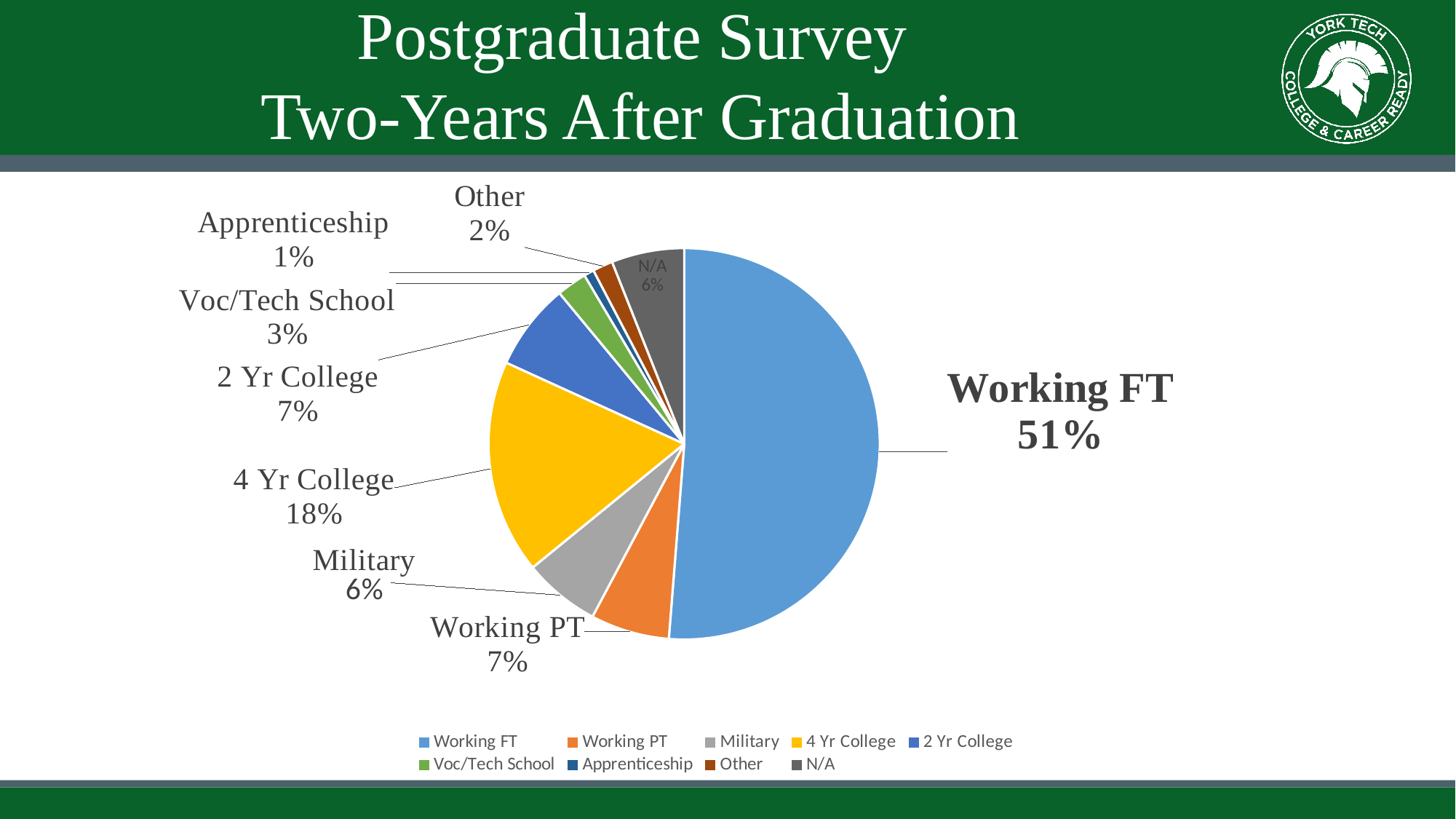
What is the difference between the Working FT and 4 Yr College values? 33% What share of the pie is Working FT? 51% Which category has the largest slice? Working FT What is the value for 4 Yr College? 18% Which category has the smallest slice? Apprenticeship What is the value for Apprenticeship? 1% What is the value for Voc/Tech School? 3% What kind of chart is shown on the slide? pie chart How many categories does the pie chart have? 9 Which is larger, 2 Yr College or Military? 2 Yr College How many entries does the legend list? 9 What colour is the 4 Yr College slice? yellow